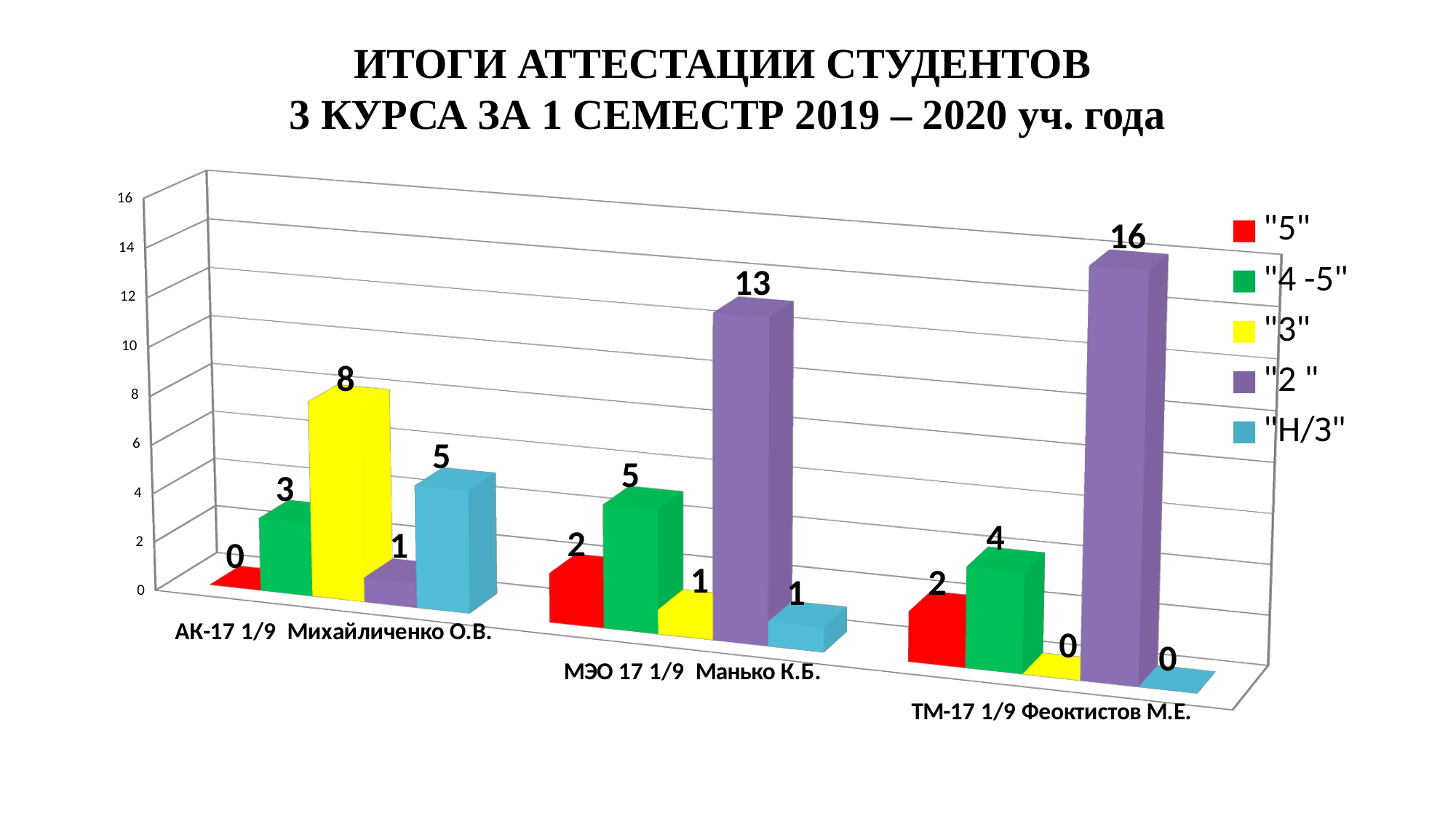
Which group has the lowest value in the "5" series? АК-17 1/9 Михайличенко О.В. What is the value of the "2 " series for МЭО 17 1/9 Манько К.Б.? 13 Which group has the highest value in the "2 " series? ТМ-17 1/9 Феоктистов М.Е. What is the difference between the "2 " values for ТМ-17 1/9 Феоктистов М.Е. and МЭО 17 1/9 Манько К.Б.? 3 What is the value of the "4 -5" series for ТМ-17 1/9 Феоктистов М.Е.? 4 How many groups (categories) are shown on the x axis? 3 What is the value of the "3" series for АК-17 1/9 Михайличенко О.В.? 8 What is the value of the "Н/З" series for АК-17 1/9 Михайличенко О.В.? 5 Which colour represents the "Н/З" series in the legend? light blue How many series does the legend list? 5 What kind of chart is shown on the slide? bar chart Which is larger: the "4 -5" value for МЭО 17 1/9 Манько К.Б. or for АК-17 1/9 Михайличенко О.В.? МЭО 17 1/9 Манько К.Б.